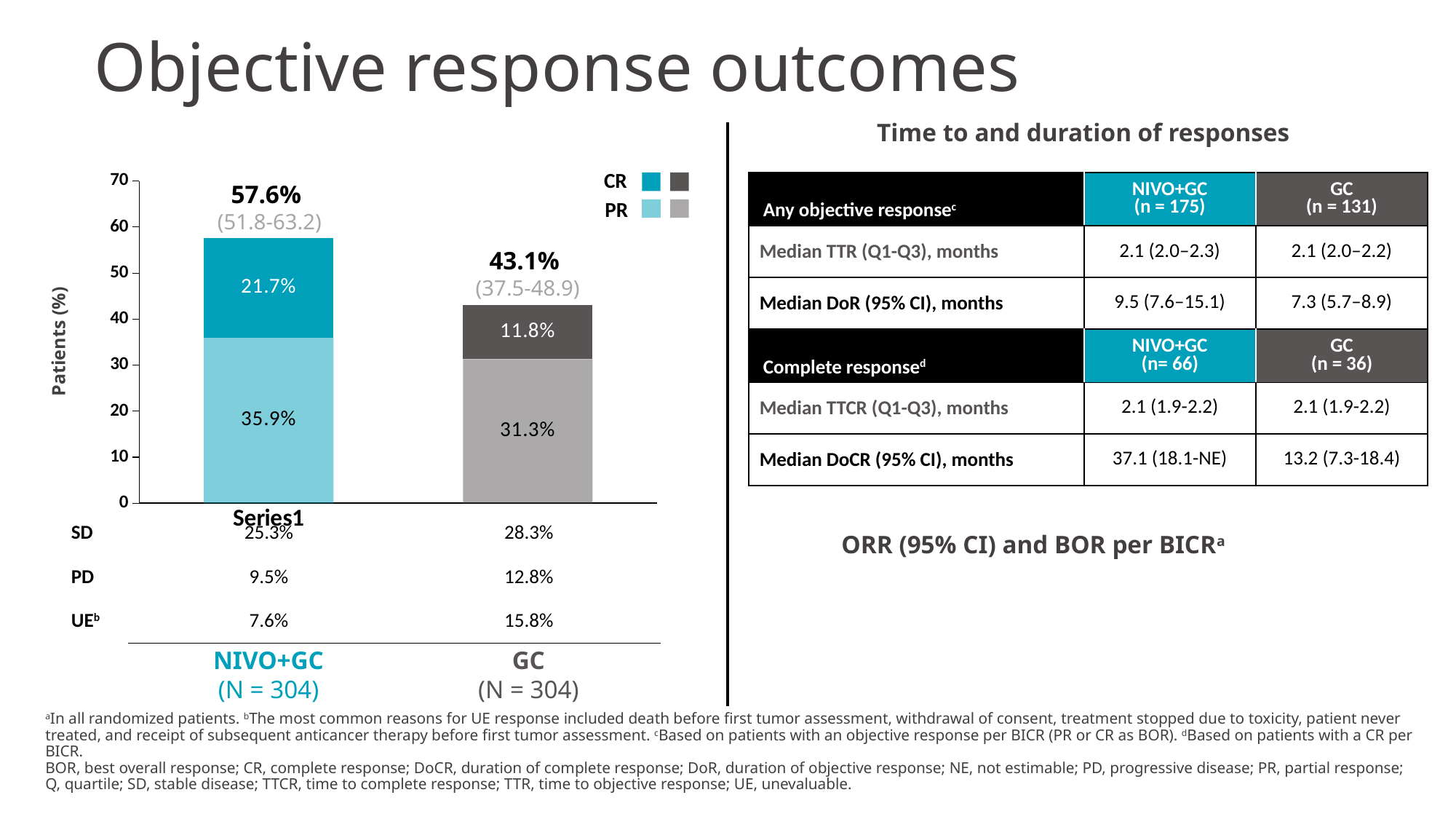
What is the PR value for the GC bar? 31.3% What is the CR value for the GC bar? 11.8% What is the difference between the CR values for NIVO+GC and GC? 9.9% What is the PR value for the NIVO+GC bar? 35.9% What is the difference between the total response rates of NIVO+GC and GC? 14.5% Which bar has the higher total response rate, NIVO+GC or GC? NIVO+GC How many bars are plotted in the chart? 2 How many series does the chart legend list? 2 What is the total objective response rate shown above the NIVO+GC bar? 57.6% What is the CR value for the NIVO+GC bar? 21.7% What type of chart is shown on the slide? Stacked bar chart What is the total objective response rate shown above the GC bar? 43.1%